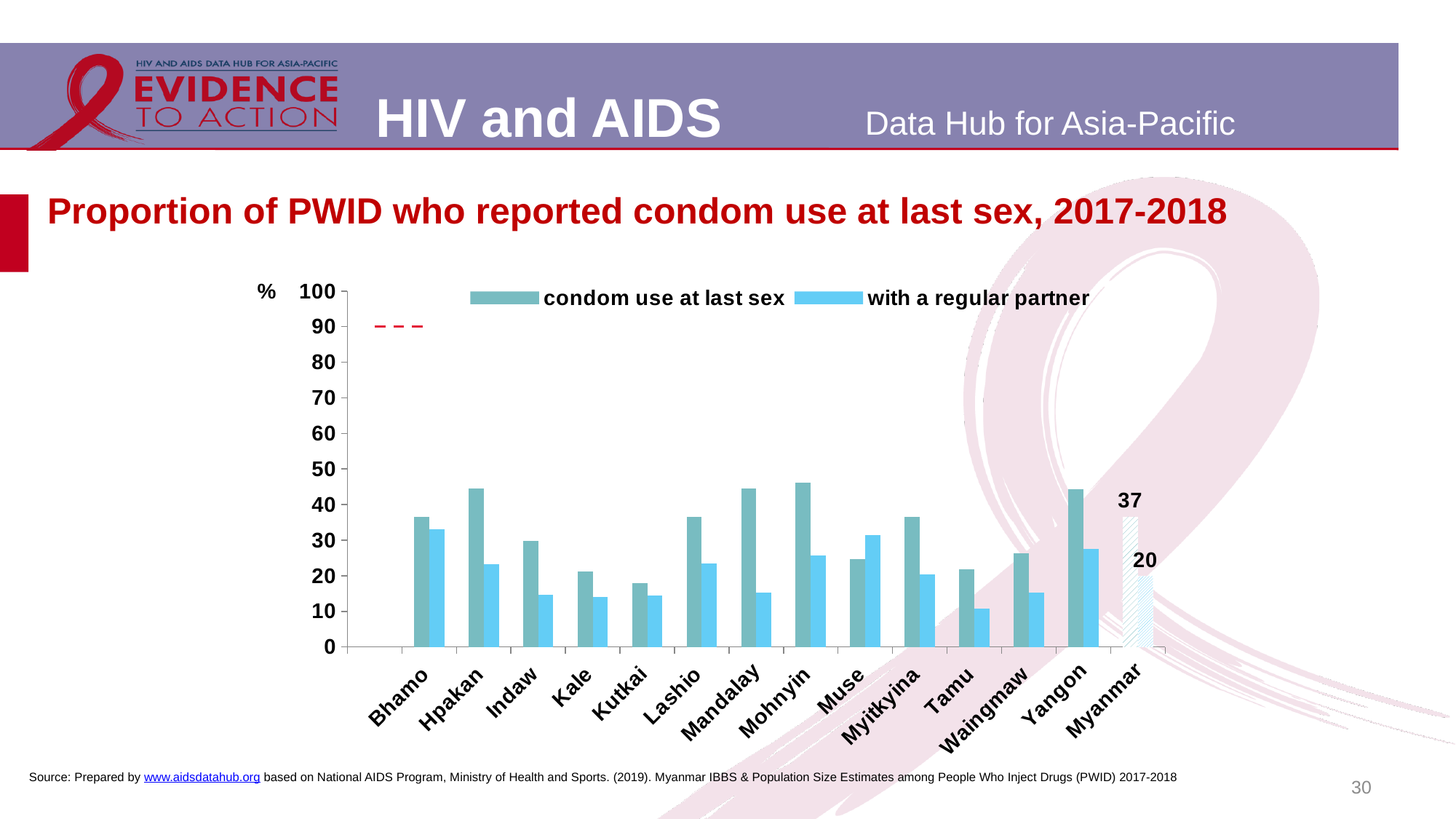
What is the difference between condom use at last sex and with a regular partner for Myanmar? 17 Is the value for with a regular partner for Tamu greater or less than 20? less How many series does the legend list? 2 How many categories are shown on the x axis? 14 Which category has the lowest value for with a regular partner? Tamu What kind of chart is shown on the slide? bar chart What is the value for with a regular partner for Myanmar? 20 What is the value for condom use at last sex for Myanmar? 37 What is the title of the chart? Proportion of PWID who reported condom use at last sex, 2017-2018 Which category has the lowest value for condom use at last sex? Kutkai Is the value for condom use at last sex for Hpakan greater or less than 40? greater For Muse, which is larger: condom use at last sex or with a regular partner? with a regular partner